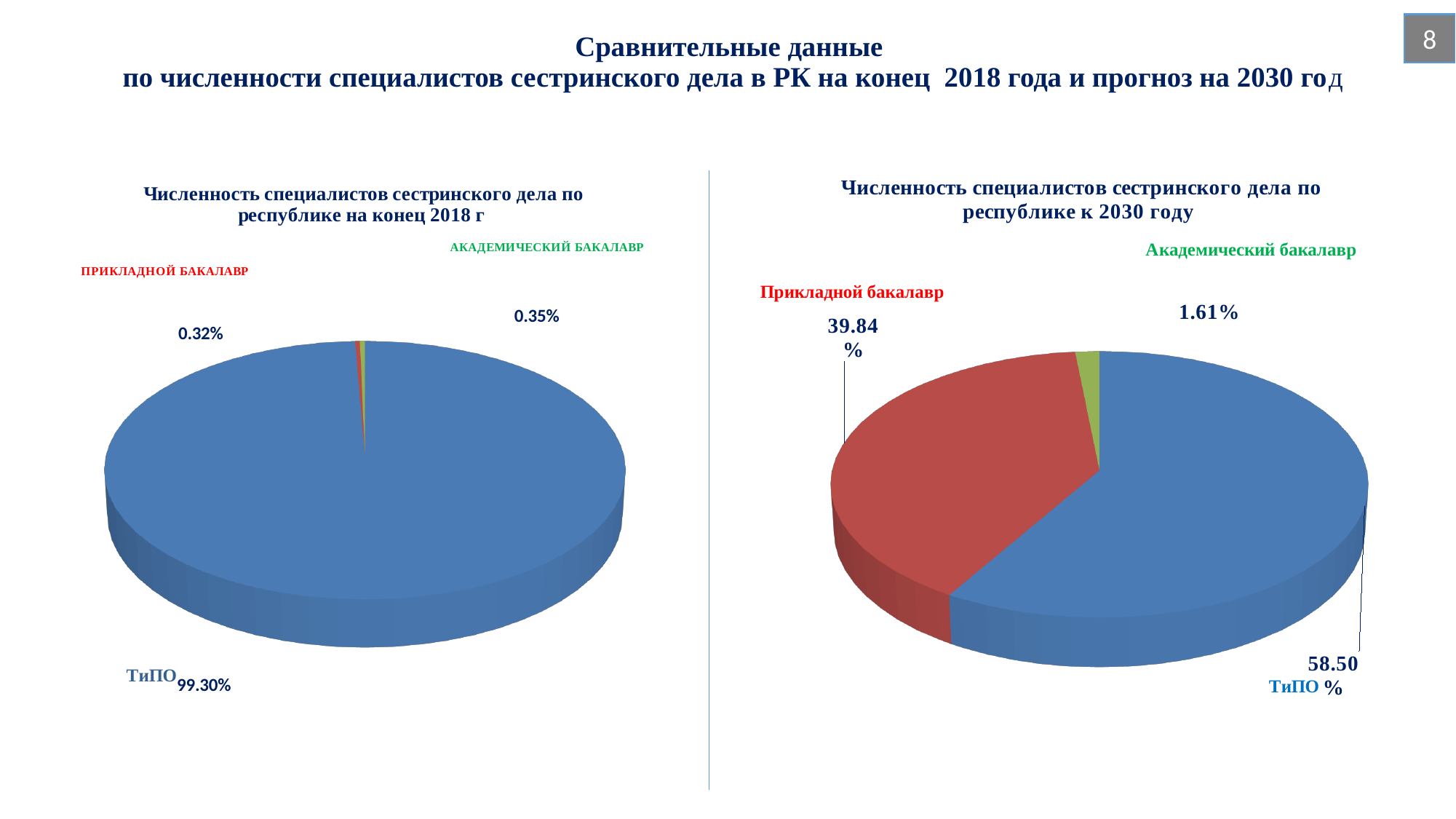
In the right chart (forecast for 2030), what is the difference between the shares of ТиПО and Прикладной бакалавр? 18.66% What is the title of the right chart? Численность специалистов сестринского дела по республике к 2030 году In the right chart (forecast for 2030), which category has the largest share? ТиПО In the right chart (forecast for 2030), what share does Академический бакалавр have? 1.61% In the right chart (forecast for 2030), what share does Прикладной бакалавр have? 39.84% In the right chart (forecast for 2030), what share does ТиПО have? 58.50% In the left chart (end of 2018), what share does Академический бакалавр have? 0.35% In the left chart (end of 2018), what share does Прикладной бакалавр have? 0.32% In the right chart (forecast for 2030), which category has the smallest share? Академический бакалавр In the left chart (end of 2018), what share does ТиПО have? 99.30% How many categories does the right chart (forecast for 2030) show? 3 What type of chart is used on the left side of the slide? Pie chart